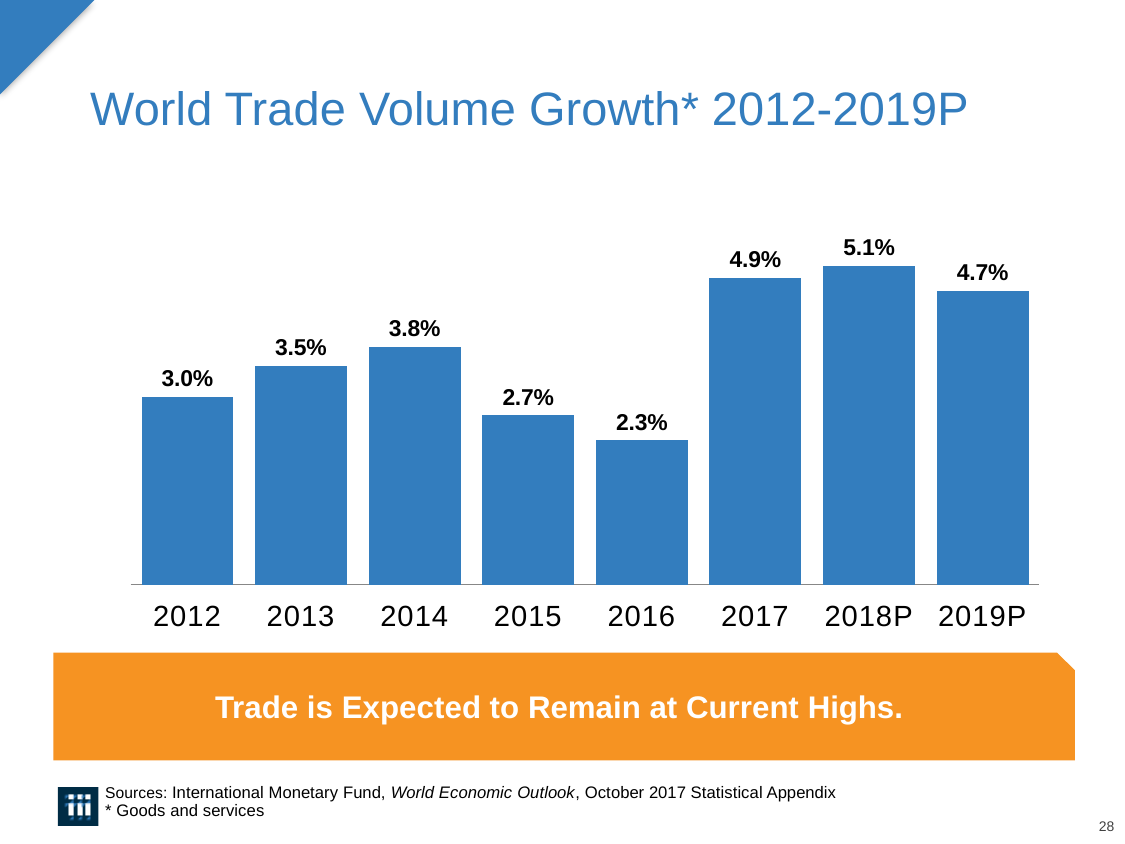
Which year has the highest world trade volume growth? 2018P What is the title of the chart? World Trade Volume Growth* 2012-2019P Which year has the lowest world trade volume growth? 2016 What kind of chart is shown on the slide? Bar chart How many years are shown on the chart? 8 What is the world trade volume growth value for 2018P? 5.1% Which is larger, the value for 2013 or the value for 2015? 2013 Do the values rise or fall from 2014 to 2016? Fall What is the world trade volume growth value for 2016? 2.3% What is the difference between the values for 2018P and 2019P? 0.4% What is the world trade volume growth value for 2014? 3.8% What is the difference between the values for 2017 and 2016? 2.6%